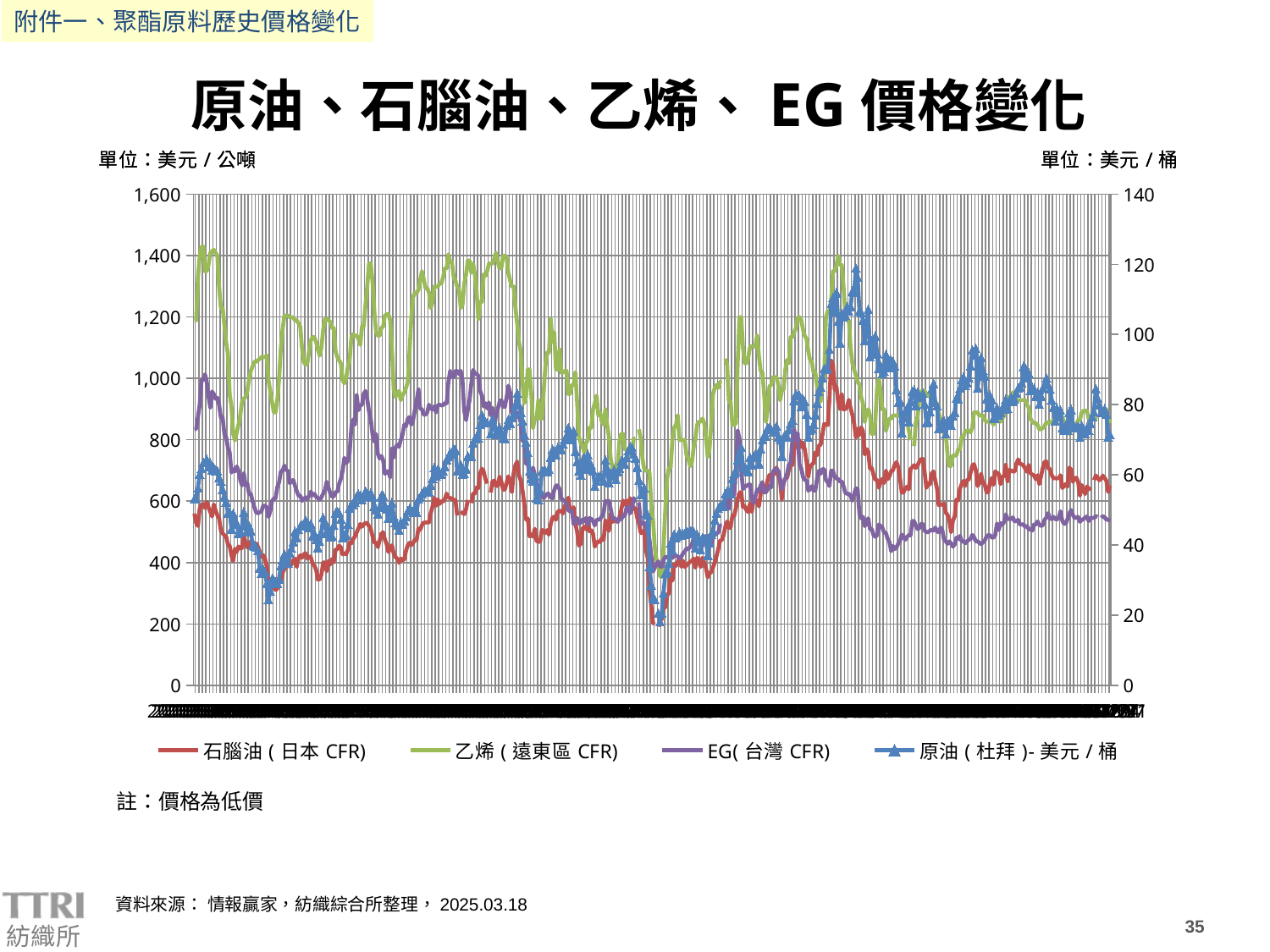
Which series generally has the highest values on the left axis across the chart, 乙烯 ( 遠東區 CFR) or 石腦油 ( 日本 CFR)? 乙烯 ( 遠東區 CFR) How many series does the legend list? 4 Is the highest value reached by the 石腦油 ( 日本 CFR) series greater or less than 1,200 on the left axis? less What is the title of the chart? 原油、石腦油、乙烯、EG 價格變化 Which series in the legend is plotted in units of 美元/桶? 原油 ( 杜拜 ) Is the highest value reached by the 原油 ( 杜拜 ) series greater or less than 100 on the right axis? greater What kind of chart is shown on the slide? line chart Is the lowest value reached by the 乙烯 ( 遠東區 CFR) series greater or less than 200 on the left axis? greater